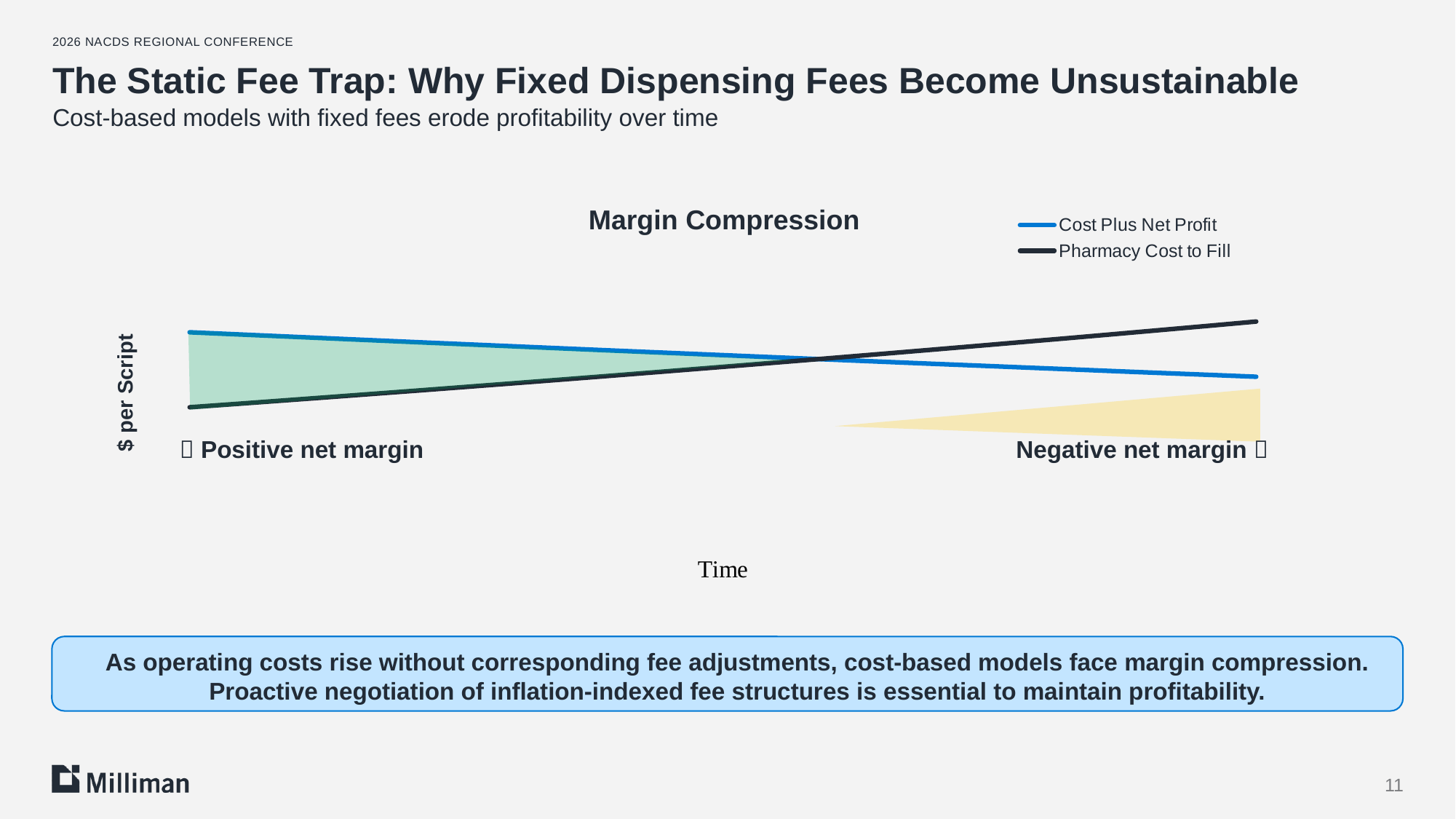
At the end of the time axis, which is higher: Cost Plus Net Profit or Pharmacy Cost to Fill? Pharmacy Cost to Fill What is the label on the horizontal axis of the chart? Time How many series does the chart's legend list? 2 What is the label on the vertical axis of the chart? $ per Script What kind of chart is shown on the slide? Line chart What is the title of the chart? Margin Compression At the start of the time axis, which is higher: Cost Plus Net Profit or Pharmacy Cost to Fill? Cost Plus Net Profit Does the Pharmacy Cost to Fill line rise or fall over time? Rises Does the Cost Plus Net Profit line rise or fall over time? Falls